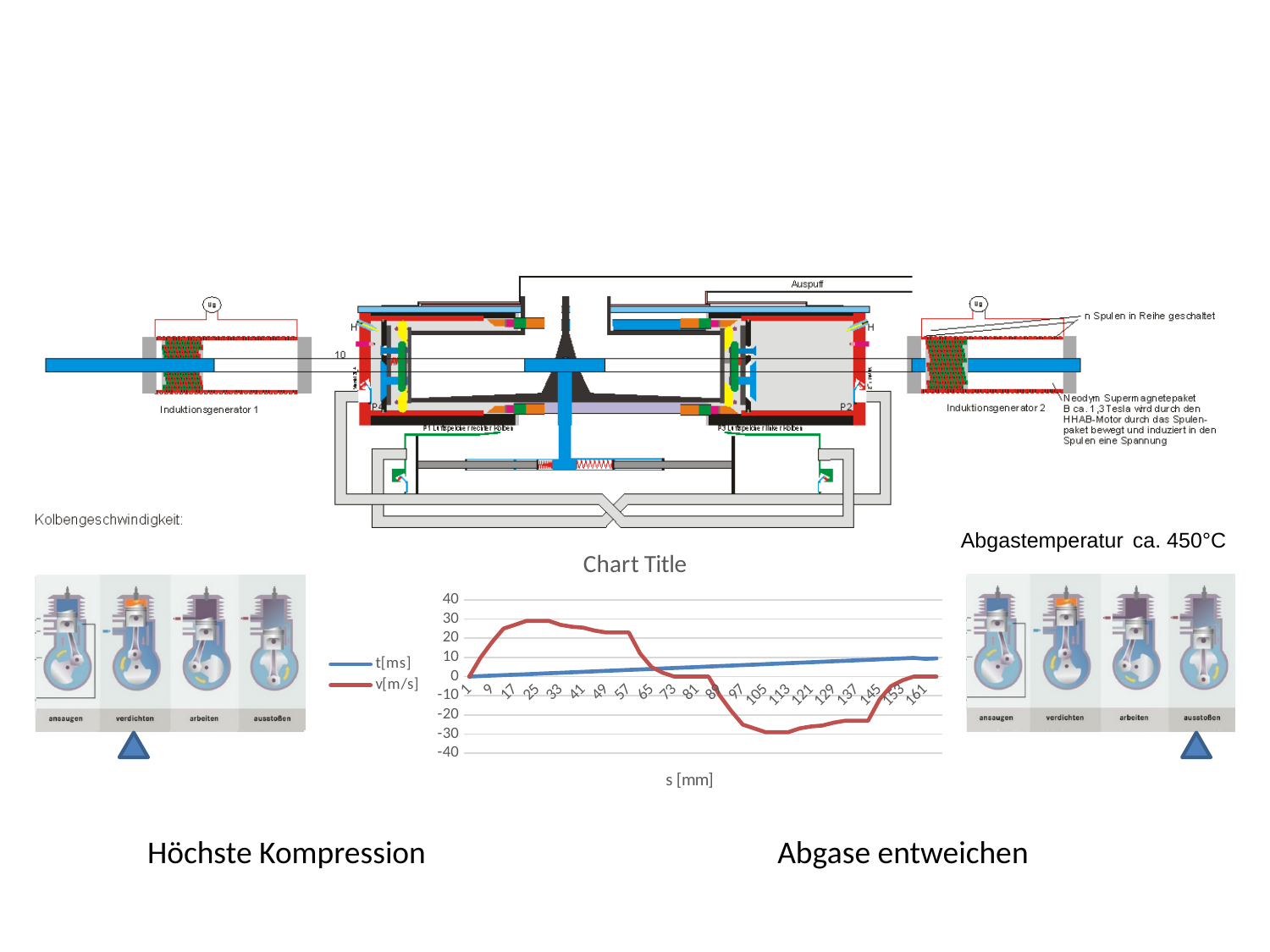
Is the value of v[m/s] at s = 25 greater or less than 20? greater Does the t[ms] series rise or fall as s increases along the x axis? rise Is the value of t[ms] at s = 81 greater or less than 10? less What is the title of the chart's x axis? s [mm] Is the value of v[m/s] at s = 57 greater or less than 10? greater What is the lowest value shown on the chart's y axis? -40 How many tick labels are shown on the chart's x axis? 21 How many series does the chart legend list? 2 What are the two series named in the chart legend? t[ms] and v[m/s] Which is larger: the value of v[m/s] at s = 25 or at s = 105? s = 25 What kind of chart is shown on the slide? line chart